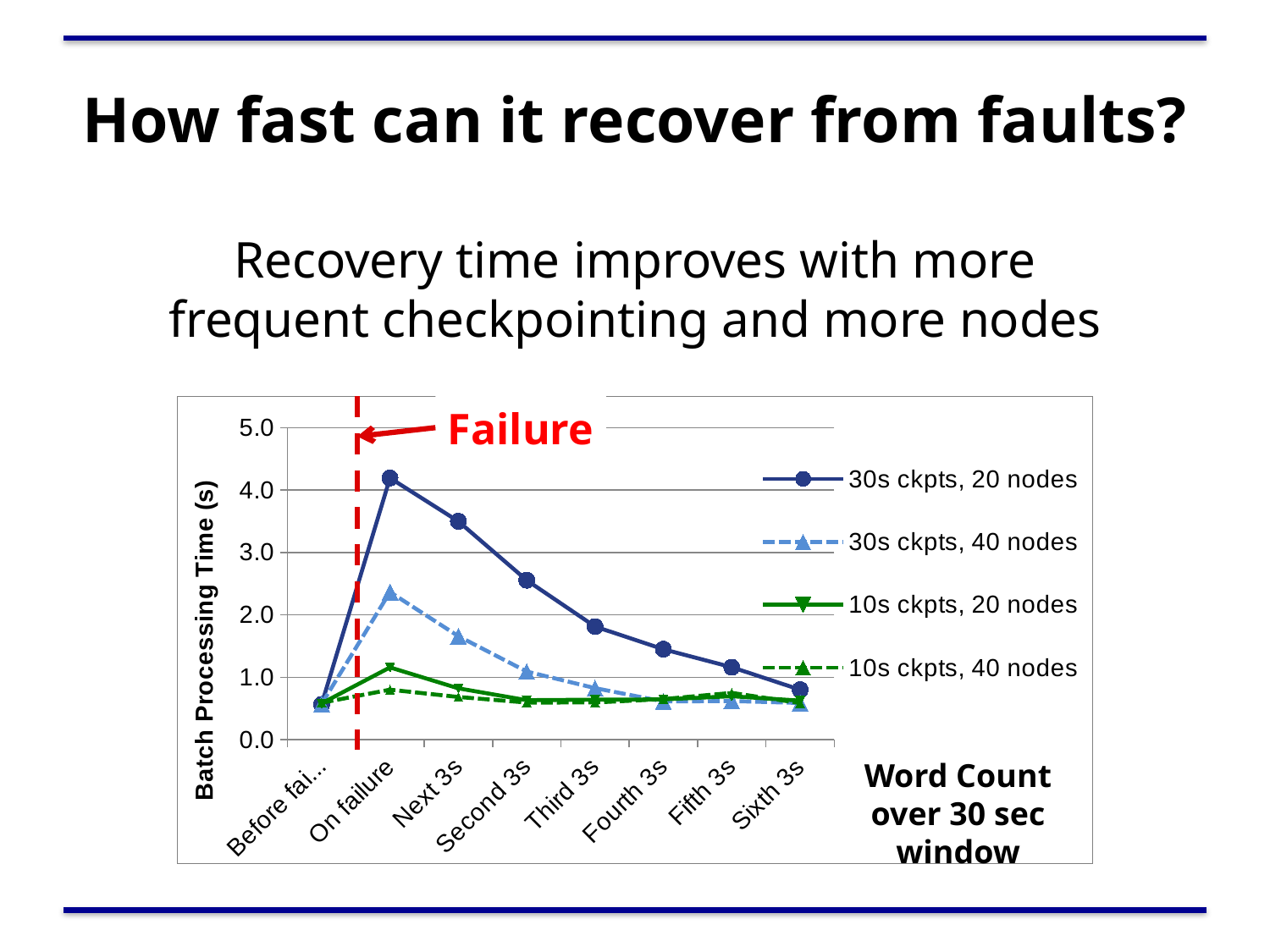
At which x-axis category does the 30s ckpts, 20 nodes series reach its highest value? On failure Is the value for 30s ckpts, 40 nodes at On failure greater or less than 2.0? greater Which series reaches the highest batch processing time on the chart? 30s ckpts, 20 nodes What is the label on the y axis of the chart? Batch Processing Time (s) From On failure to Sixth 3s, does the 30s ckpts, 20 nodes series rise or fall? fall What kind of chart is shown on the slide? line chart At On failure, which series has the larger value: 30s ckpts, 20 nodes or 30s ckpts, 40 nodes? 30s ckpts, 20 nodes Is the value for 10s ckpts, 20 nodes at On failure greater or less than 2.0? less Is the value for 10s ckpts, 40 nodes at On failure greater or less than 1.0? less How many series does the legend list? 4 How many categories are plotted along the x axis? 8